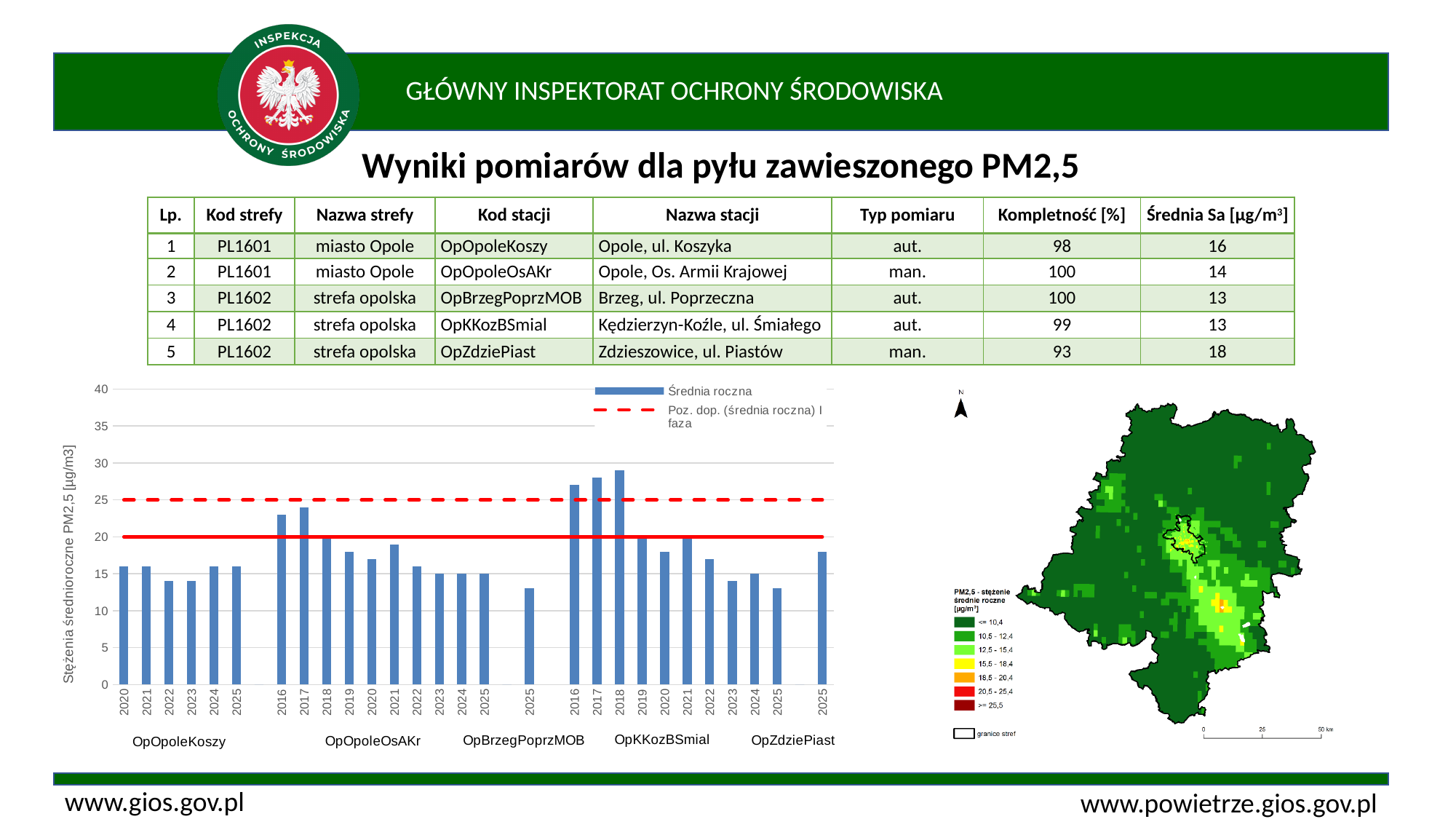
Do the values for OpKKozBSmial rise or fall from 2016 to 2018? rise How many entries does the legend of the bar chart list? 2 How many bars are plotted for the station OpOpoleKoszy? 6 Which is larger: the bar for OpOpoleOsAKr in 2016 or the bar for OpOpoleKoszy in 2020? OpOpoleOsAKr in 2016 Which station and year has the highest bar in the chart? OpKKozBSmial, 2018 How many bars are plotted for the station OpBrzegPoprzMOB? 1 At what level on the y axis is the red dashed line 'Poz. dop. (średnia roczna) I faza' drawn? 25 Is the value for OpOpoleKoszy in 2022 greater or less than 15? less Is the value for OpOpoleOsAKr in 2016 greater or less than 20? greater What kind of chart is shown at the bottom left of the slide? bar chart Is the value for OpKKozBSmial in 2017 greater or less than 25? greater